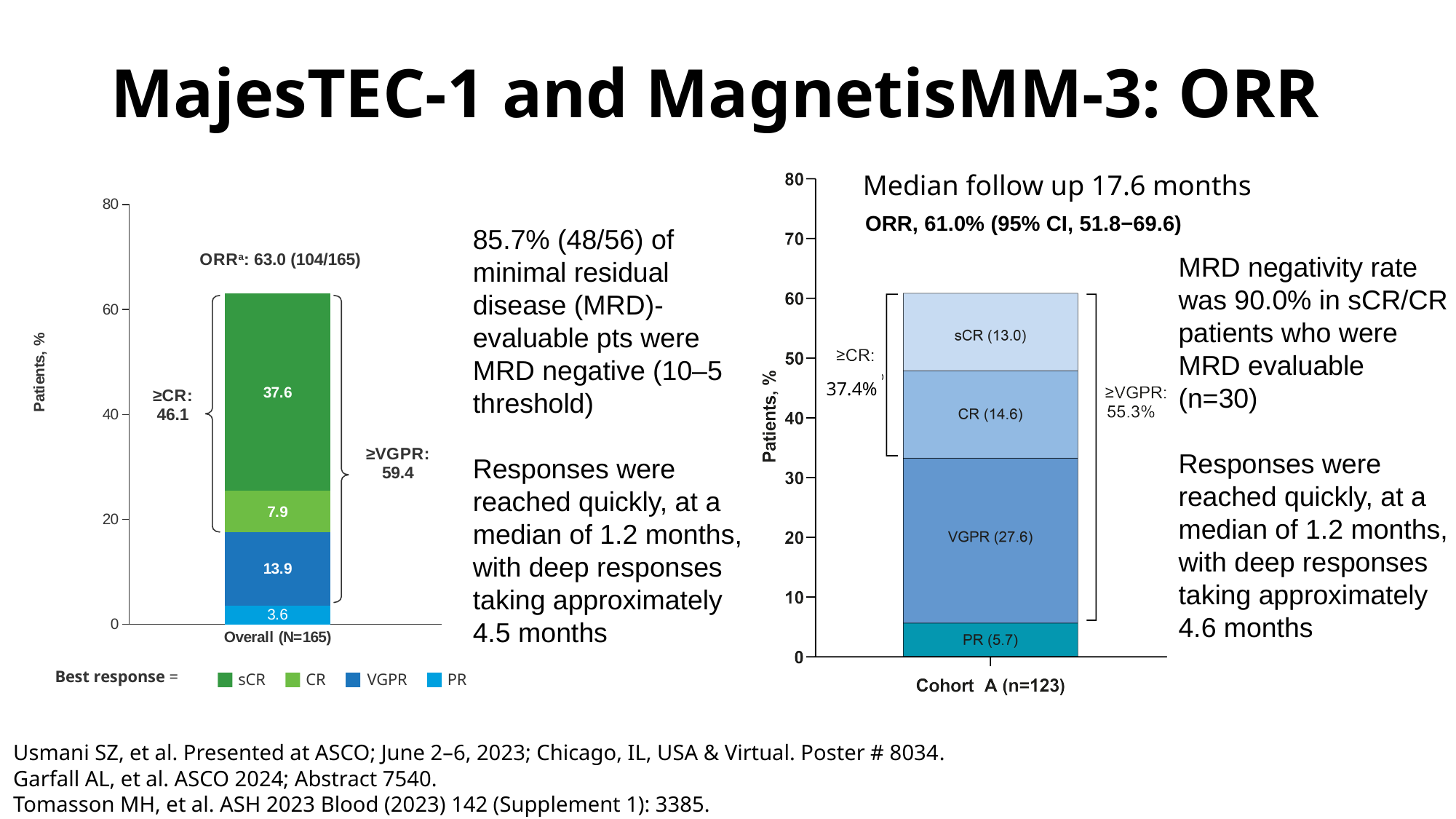
How many response categories does the legend of the left chart list? 4 In the left chart (Overall, N=165), what is the difference between the sCR and VGPR segment values? 23.7 What is the ORR shown above the bar in the left chart (Overall, N=165)? 63.0 (104/165) In the right chart (Cohort A, n=123), what is the value of the VGPR segment? 27.6 What type of chart is shown on the left side of the slide? Stacked bar chart In the right chart (Cohort A, n=123), which segment is larger, sCR or VGPR? VGPR In the right chart (Cohort A, n=123), which response category has the smallest segment? PR In the left chart (Overall, N=165), which response category has the largest segment? sCR In the right chart (Cohort A, n=123), what is the ≥VGPR rate shown beside the bar? 55.3% In the right chart (Cohort A, n=123), what is the value of the CR segment? 14.6 In the left chart (Overall, N=165), what is the value of the PR segment? 3.6 In the left chart (Overall, N=165), what is the value of the sCR segment? 37.6